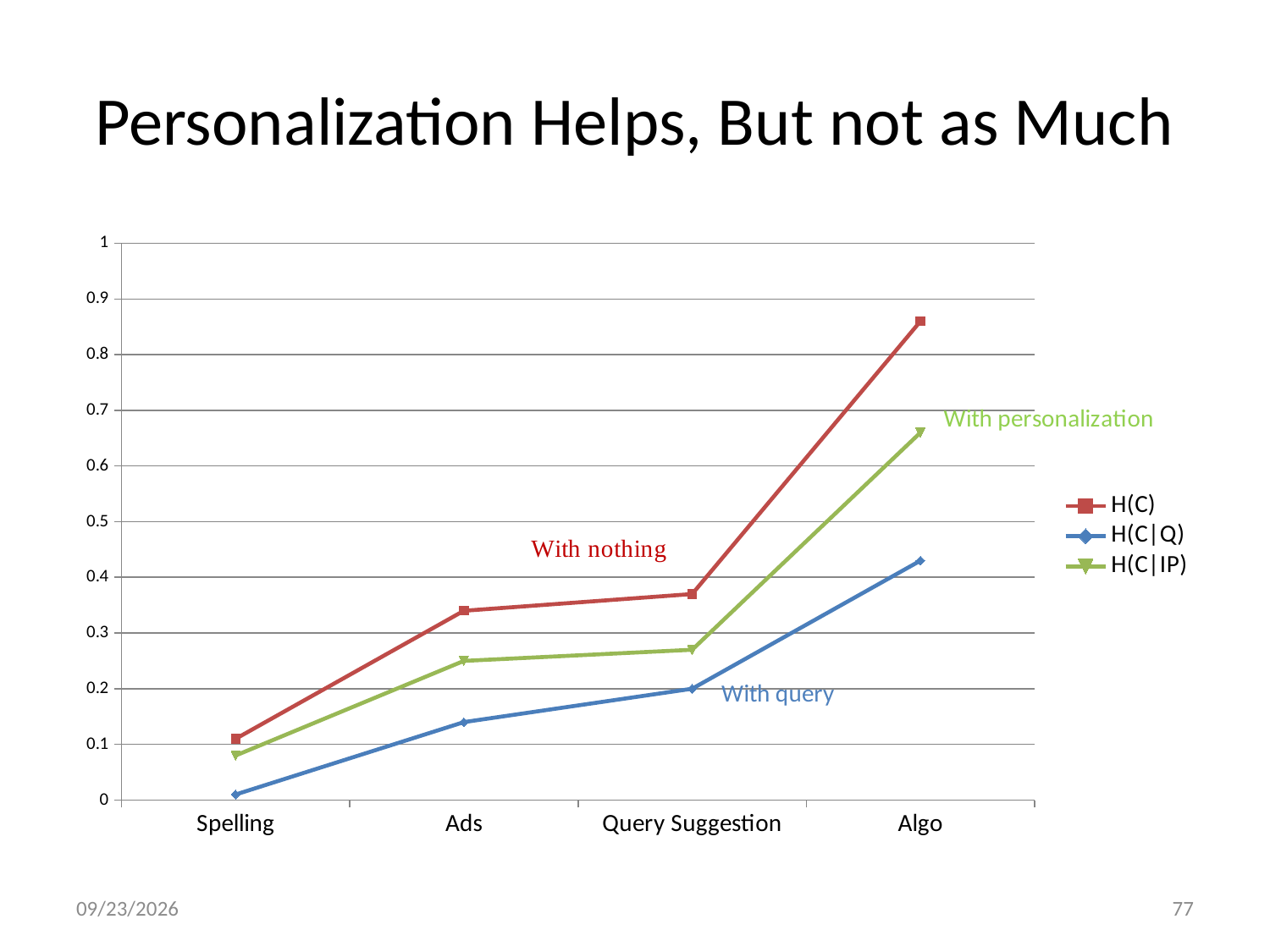
How many categories are shown on the x axis? 4 Is the value of H(C|IP) for Algo greater or less than 0.6? greater Is the value of H(C|Q) for Algo greater or less than 0.5? less Do the values of the H(C|IP) series rise or fall from Spelling to Algo? rise Which is larger at Algo, H(C) or H(C|Q)? H(C) Is the value of H(C) for Ads greater or less than 0.3? greater How many series does the legend list? 3 Which series is annotated as "With personalization"? H(C|IP) For which category is the H(C) series highest? Algo What kind of chart is shown on the slide? line chart For which category is the H(C|Q) series lowest? Spelling